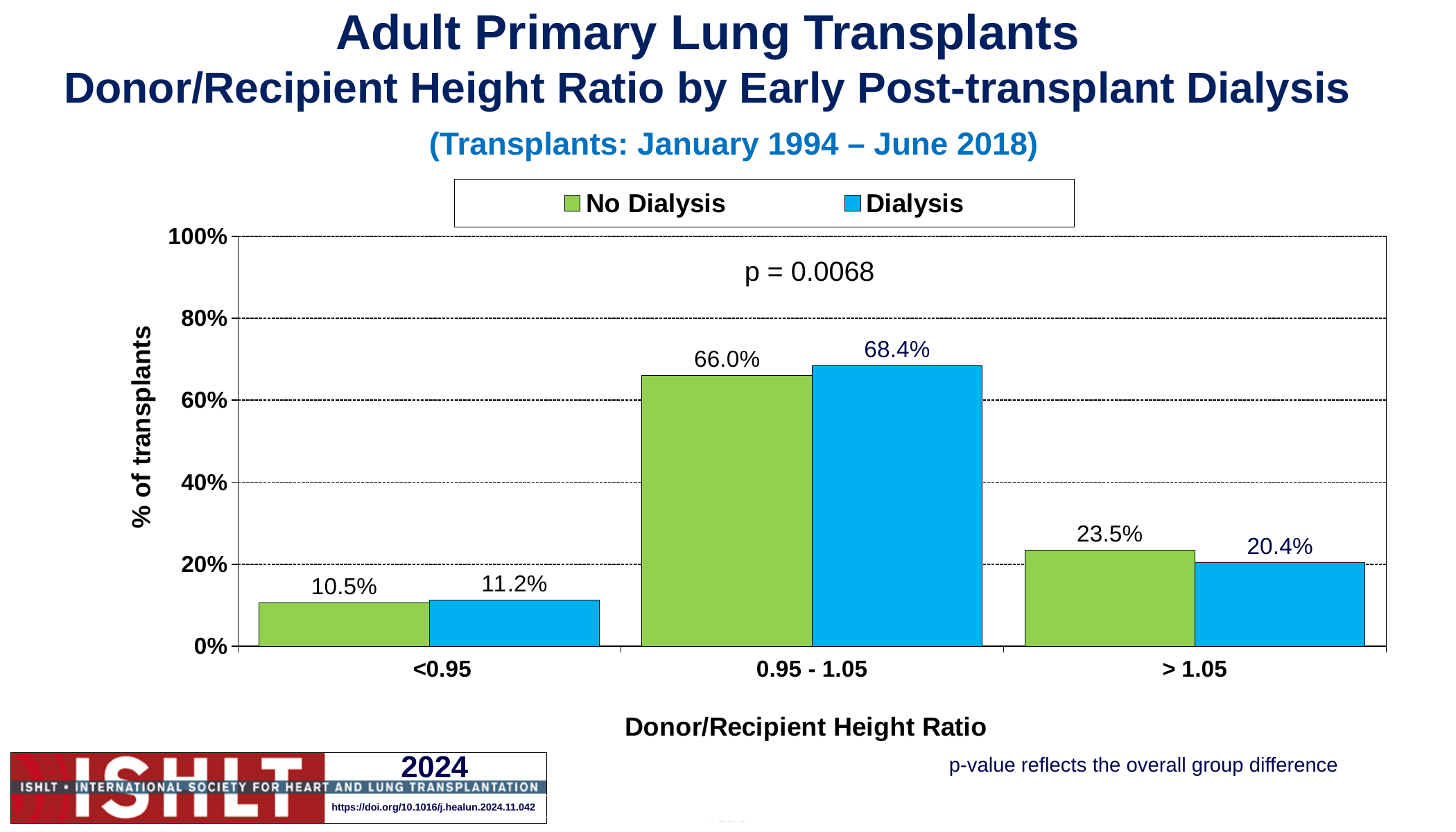
Which height ratio category has the highest value for the No Dialysis group? 0.95 - 1.05 Is the No Dialysis value for the <0.95 category greater or less than 20%? less What is the difference between the Dialysis and No Dialysis values in the 0.95 - 1.05 category? 2.4% How many series does the legend list? 2 What percentage of transplants in the Dialysis group had a donor/recipient height ratio of > 1.05? 20.4% Which height ratio category has the lowest value for the Dialysis group? <0.95 In the > 1.05 category, which group has the larger value, No Dialysis or Dialysis? No Dialysis What is the value for the Dialysis group in the <0.95 height ratio category? 11.2% What p-value is shown on the chart? p = 0.0068 What is the difference between the No Dialysis and Dialysis values in the > 1.05 category? 3.1% What percentage of transplants in the No Dialysis group had a donor/recipient height ratio of 0.95 - 1.05? 66.0% How many donor/recipient height ratio categories are shown on the x axis? 3